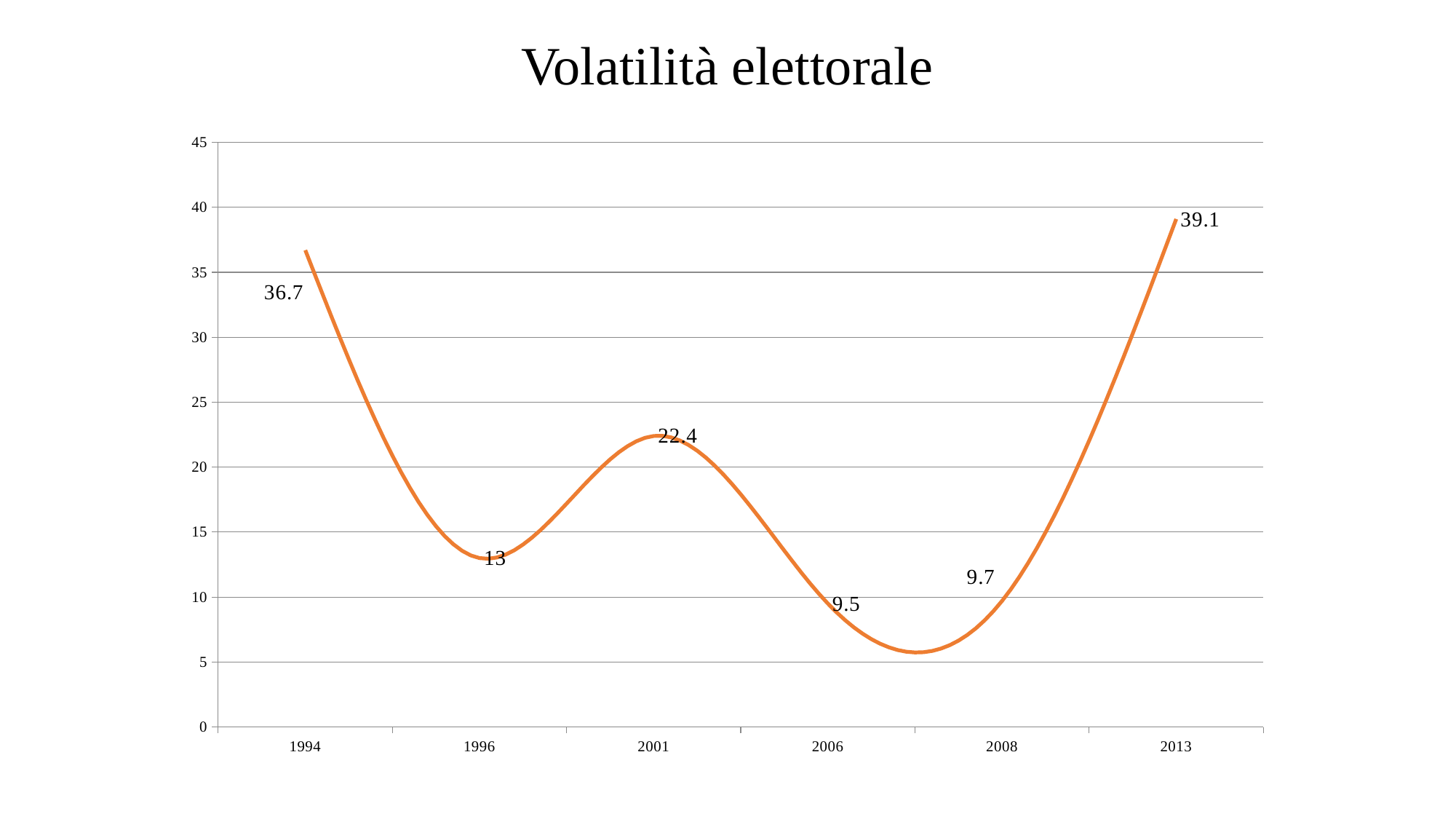
Which year has the lowest value? 2006 What is the difference between the values for 2001 and 1996? 9.4 What kind of chart is shown? line chart What is the value for 1994? 36.7 What is the title of the chart? Volatilità elettorale What is the difference between the values for 2013 and 1994? 2.4 How many years are plotted on the x axis? 6 What is the value for 1996? 13 Which year has the highest value? 2013 What is the value for 2001? 22.4 What is the value for 2013? 39.1 Which is larger, the value for 2001 or the value for 2008? 2001